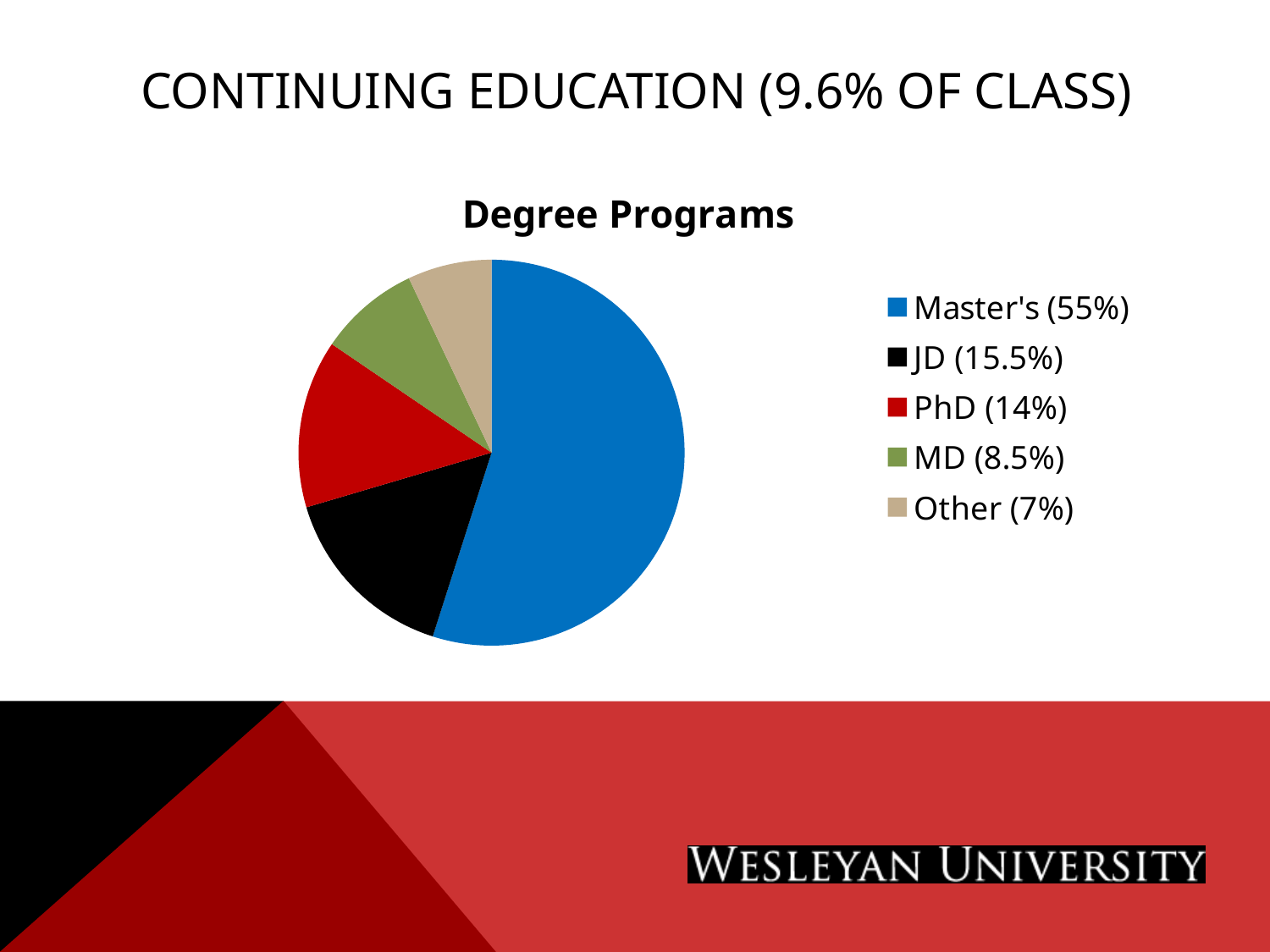
Which is larger, the PhD slice or the MD slice? PhD What share of the pie does JD represent? 15.5% Which degree program has the largest slice? Master's Which degree program has the smallest slice? Other What share of the pie does Master's represent? 55% What share of the pie does MD represent? 8.5% What is the difference in percentage points between Master's and JD? 39.5 What type of chart is shown on the slide? pie chart How many slices does the pie chart have? 5 What colour is the Master's slice? blue What is the title of the chart? Degree Programs